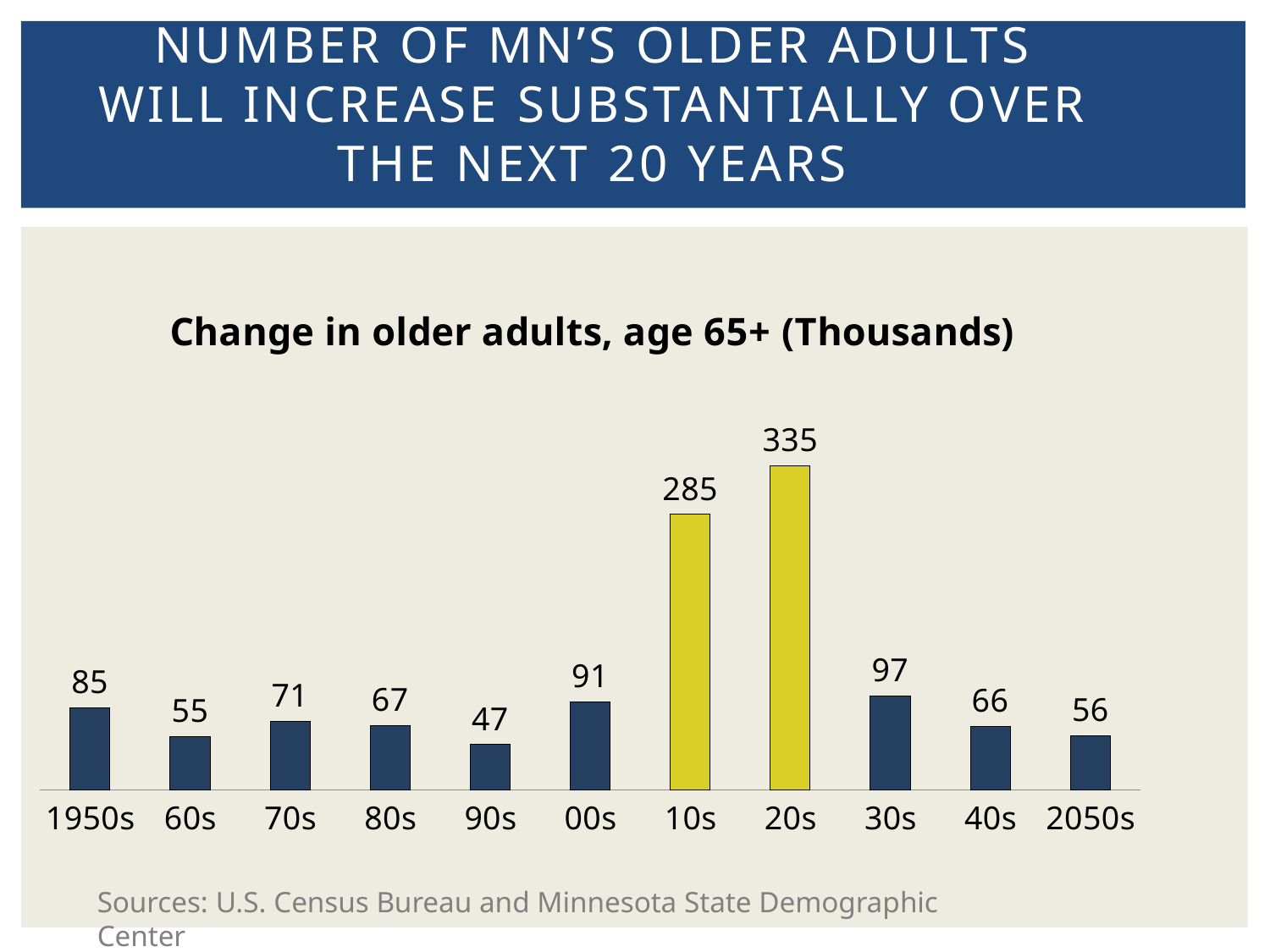
What kind of chart is shown on the slide? Bar chart Which is larger, the value for the 70s or the value for the 80s? 70s Which decade has the lowest value? 90s Which decade has the highest value? 20s What is the value for the 90s? 47 What is the title of the chart? Change in older adults, age 65+ (Thousands) What is the value for the 1950s? 85 What is the difference between the values for the 30s and the 2050s? 41 How many decades are shown on the x axis? 11 What is the difference between the values for the 20s and the 10s? 50 What is the value for the 20s in the chart? 335 Do the values rise or fall from the 90s to the 20s? Rise